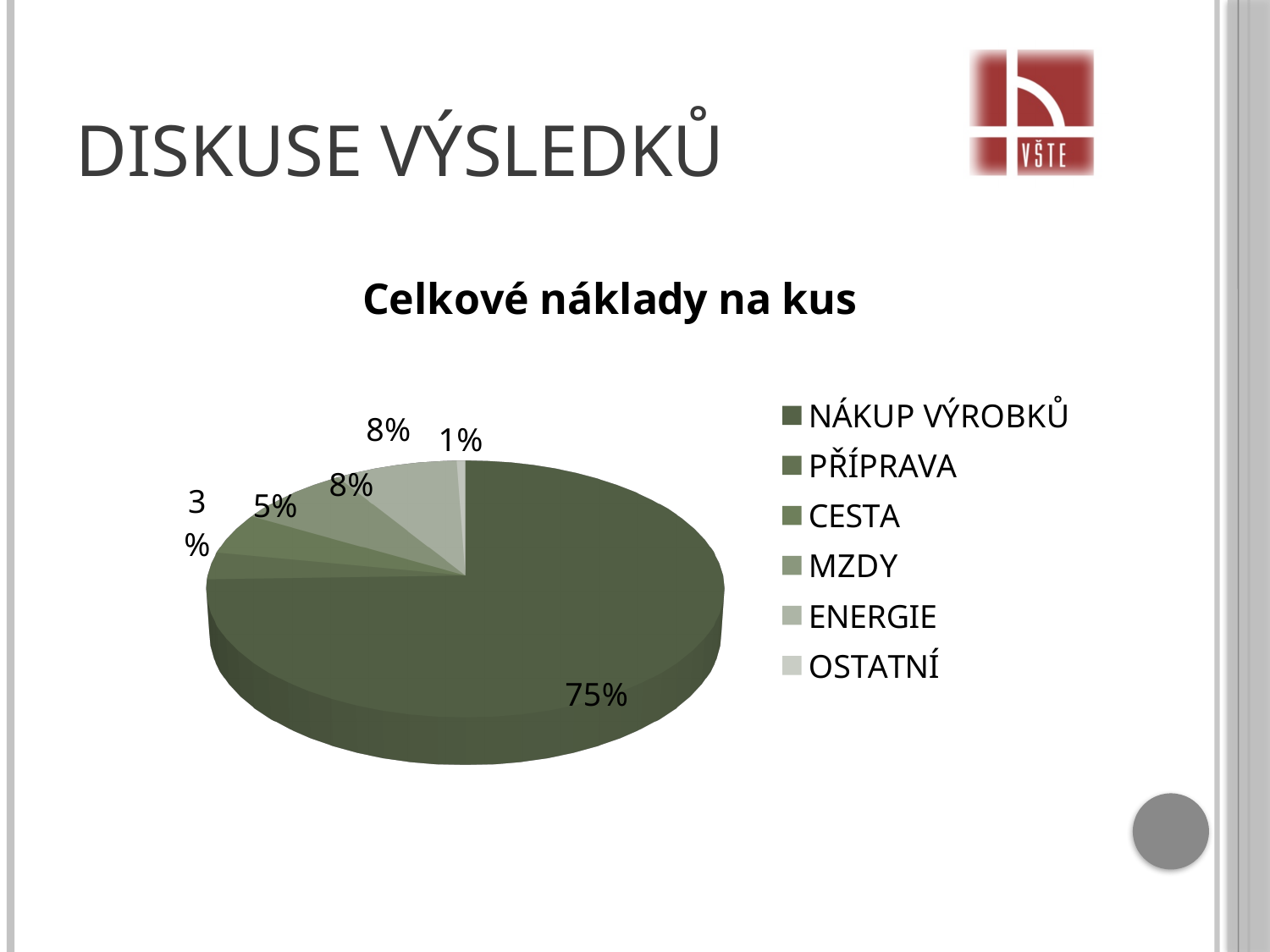
What is the title of the chart? Celkové náklady na kus Which category has the smallest share of the pie? OSTATNÍ What share of the pie does OSTATNÍ represent? 1% Which has a larger share, CESTA or PŘÍPRAVA? CESTA What is the value shown for CESTA? 5% What share of the pie does NÁKUP VÝROBKŮ represent? 75% What is the difference between the shares of NÁKUP VÝROBKŮ and ENERGIE? 67% What type of chart is shown on the slide? pie chart What is the value shown for MZDY? 8% What is the value shown for PŘÍPRAVA? 3% How many categories does the pie chart have? 6 Which category has the largest share of the pie? NÁKUP VÝROBKŮ